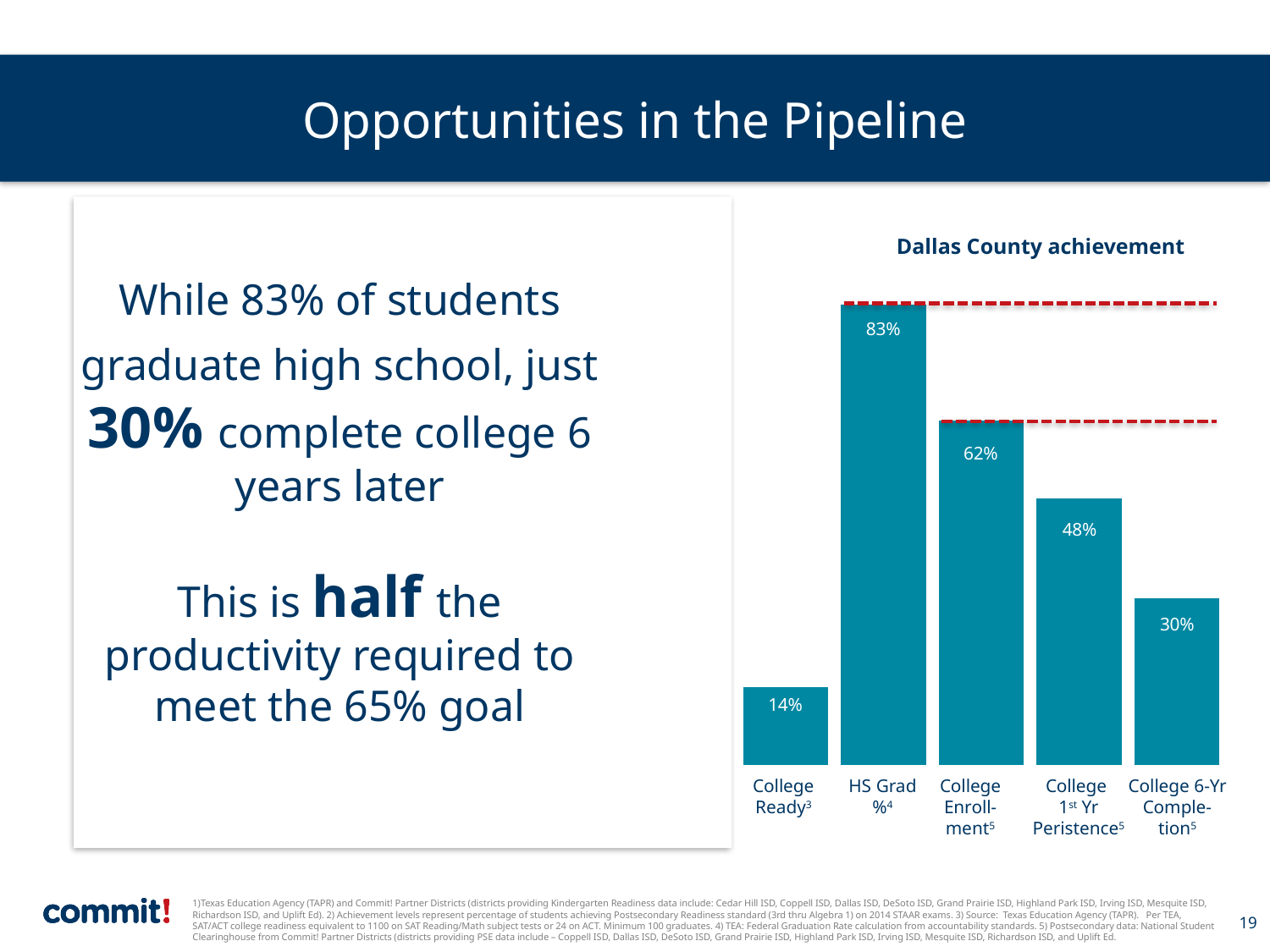
What is the difference between the HS Grad % value and the College 6-Yr Completion value? 53% What type of chart is the Dallas County achievement chart? Bar chart What is the value for HS Grad % in the Dallas County achievement chart? 83% What is the difference between the College Enrollment value and the College 1st Yr Persistence value? 14% How many categories are shown in the Dallas County achievement chart? 5 Which is larger, the value for College Enrollment or the value for College 6-Yr Completion? College Enrollment What is the value for College Enrollment in the Dallas County achievement chart? 62% Which category has the lowest value in the Dallas County achievement chart? College Ready What is the value for College Ready in the Dallas County achievement chart? 14% What is the value for College 6-Yr Completion in the Dallas County achievement chart? 30% Which category has the highest value in the Dallas County achievement chart? HS Grad % What is the value for College 1st Yr Persistence in the Dallas County achievement chart? 48%